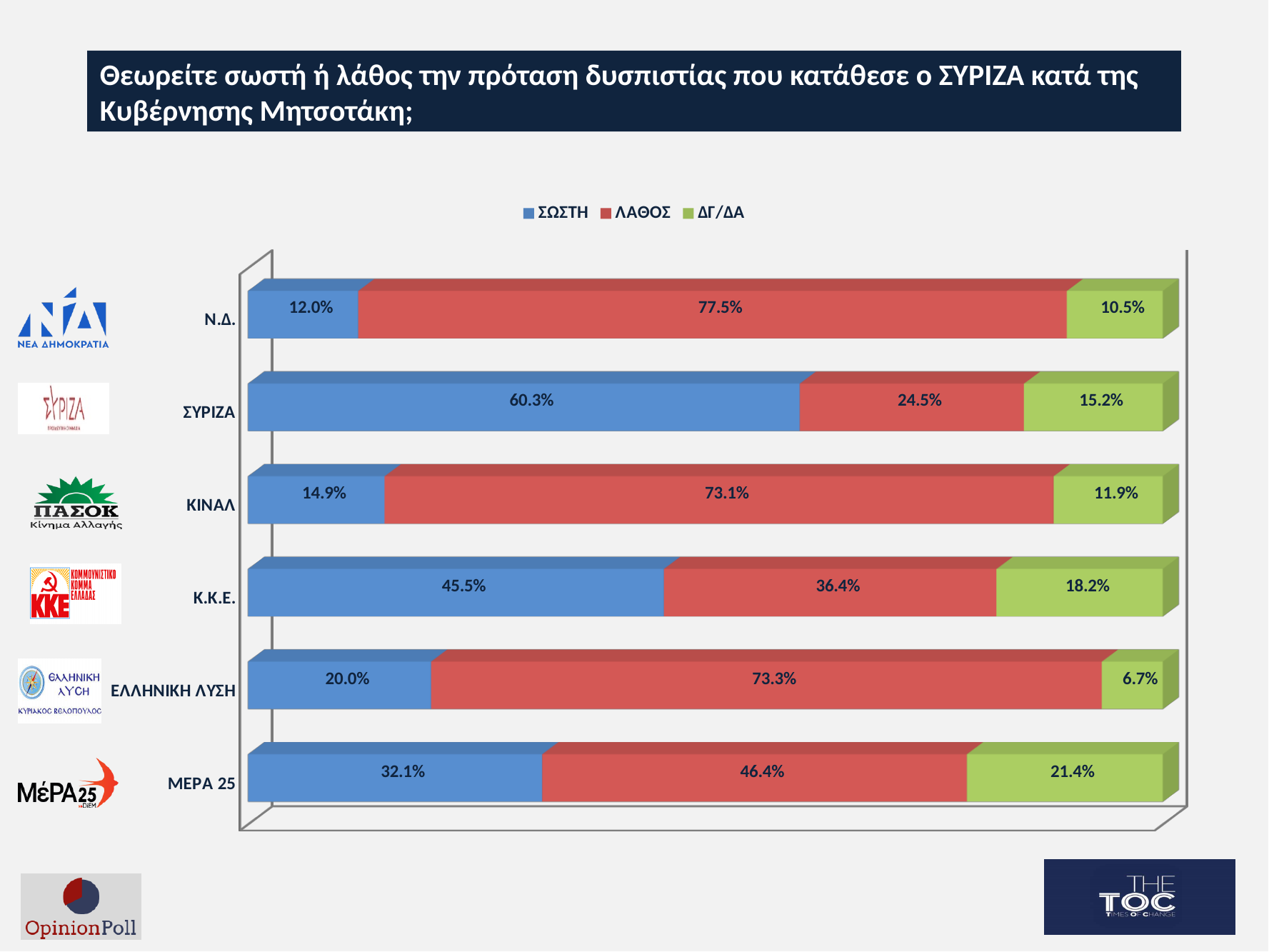
Which category has the highest ΣΩΣΤΗ value? ΣΥΡΙΖΑ Which is larger: the ΣΩΣΤΗ value for Κ.Κ.Ε. or the ΣΩΣΤΗ value for ΜΕΡΑ 25? Κ.Κ.Ε. What is the ΛΑΘΟΣ value for ΕΛΛΗΝΙΚΗ ΛΥΣΗ? 73.3% What is the ΔΓ/ΔΑ value for ΜΕΡΑ 25? 21.4% What is the ΣΩΣΤΗ value for ΣΥΡΙΖΑ? 60.3% What is the difference between the ΛΑΘΟΣ value for ΚΙΝΑΛ and the ΛΑΘΟΣ value for Κ.Κ.Ε.? 36.7% Which category has the lowest ΔΓ/ΔΑ value? ΕΛΛΗΝΙΚΗ ΛΥΣΗ How many categories (parties) are shown in the chart? 6 Which category has the lowest ΣΩΣΤΗ value? Ν.Δ. What is the ΛΑΘΟΣ value for Ν.Δ.? 77.5% What kind of chart is shown on the slide? Stacked bar chart How many series does the legend list? 3